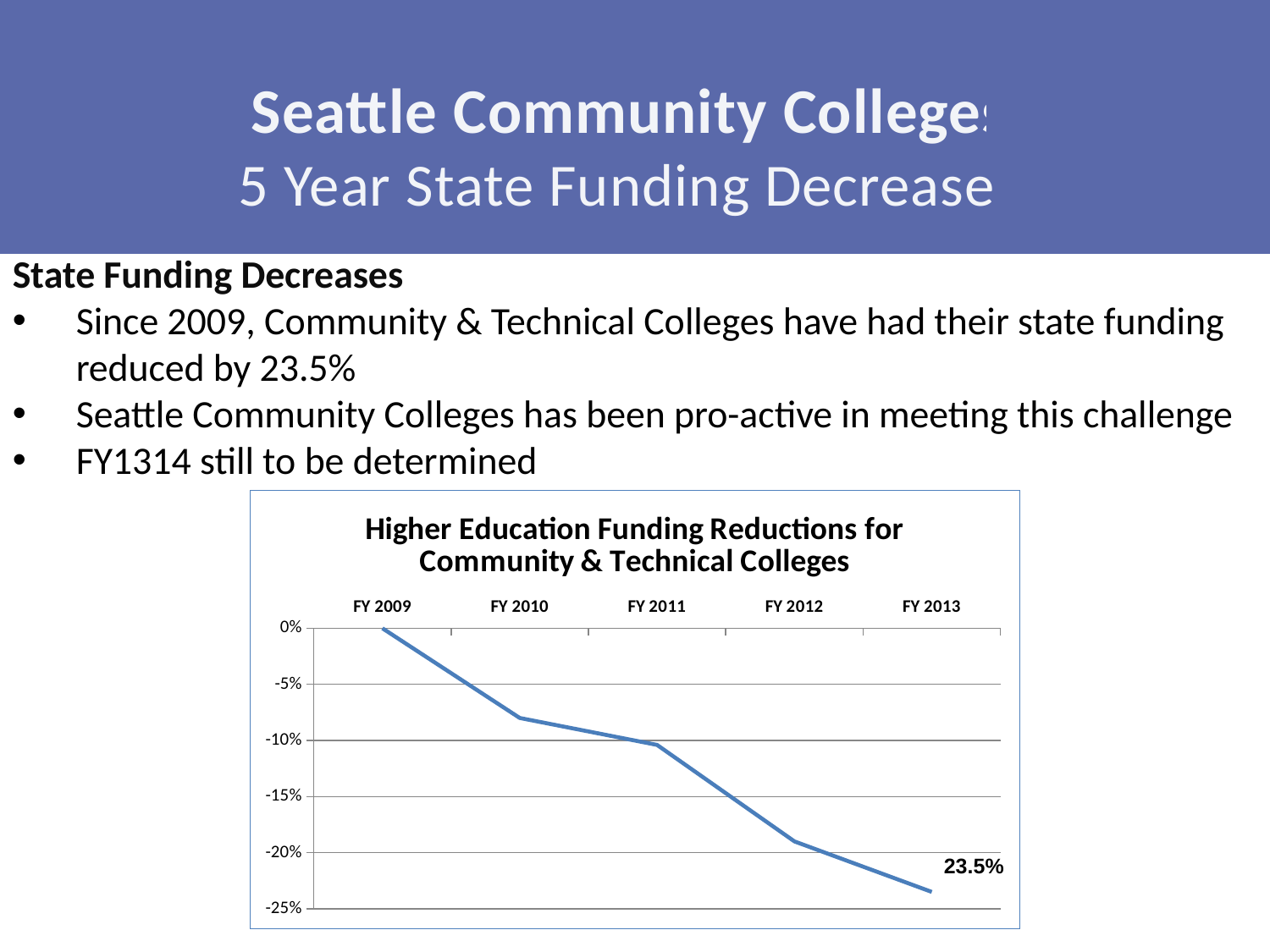
How many fiscal years are plotted on the chart? 5 Is the value for FY 2010 greater or less than -5%? less Do the values rise or fall from FY 2009 to FY 2013? fall Which is larger, the value for FY 2010 or the value for FY 2012? FY 2010 Is the value for FY 2012 greater or less than -15%? less What is the title of the chart? Higher Education Funding Reductions for Community & Technical Colleges Is the value for FY 2011 greater or less than -15%? greater What is the value plotted for FY 2009? 0% What kind of chart is shown on the slide? line chart Which fiscal year has the lowest value on the chart? FY 2013 Which fiscal year has the highest value on the chart? FY 2009 What value is labelled on the chart for FY 2013? 23.5%